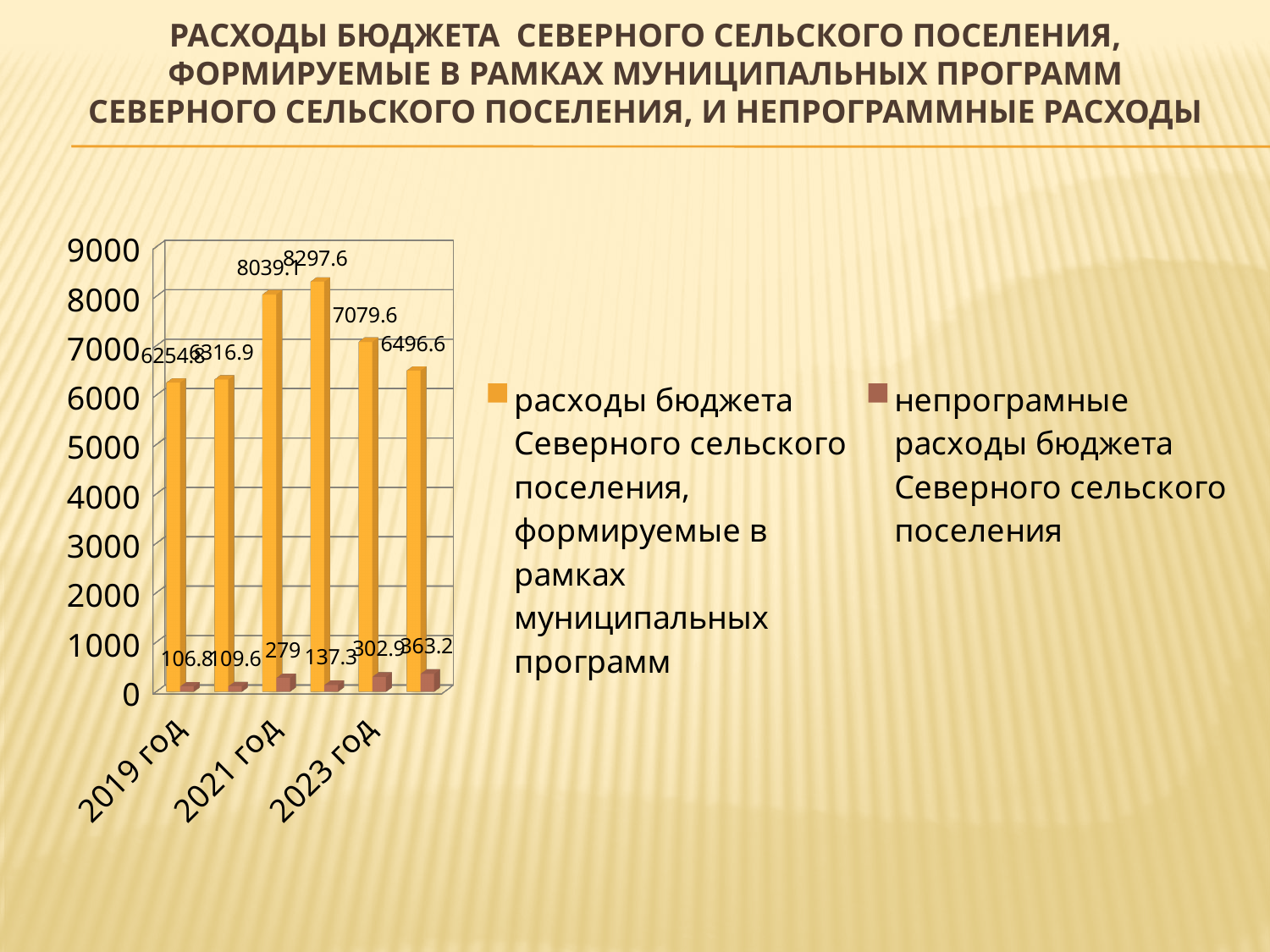
What is the highest value shown for the program-based budget expenses series? 8297.6 What kind of chart is shown on the slide? bar chart What is the value of the program-based budget expenses for 2023 год? 7079.6 What is the value of the non-program expenses for 2023 год? 302.9 What is the difference between the program-based budget expenses for 2021 год and 2023 год? 959.5 Is the value of the program-based budget expenses for 2019 год greater or less than 7000? less What is the lowest value shown for the non-program expenses series? 106.8 What is the value of the program-based budget expenses (расходы бюджета, формируемые в рамках муниципальных программ) for 2021 год? 8039.1 What is the value of the non-program expenses for 2021 год? 279 Which year has larger program-based budget expenses, 2021 год or 2023 год? 2021 год What is the value of the non-program expenses (непрограмные расходы) for 2019 год? 106.8 How many series does the legend list? 2